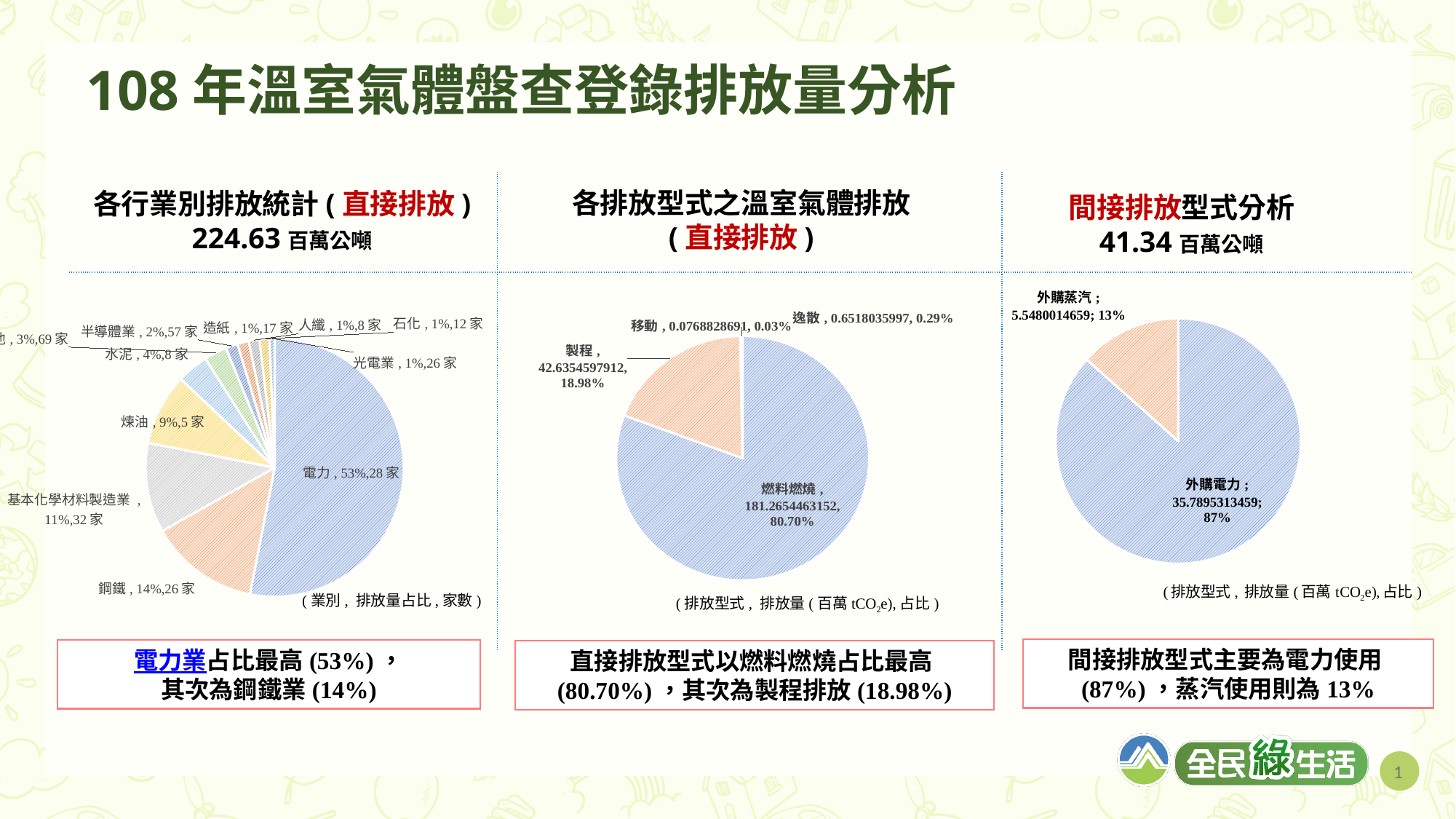
What type of chart is used for the 間接排放型式分析 on the right? Pie chart In the left chart (各行業別排放統計), how many 家 (companies) are listed for 鋼鐵? 26 家 In the middle chart (各排放型式之溫室氣體排放), which emission type has the smallest share? 移動 In the left chart (各行業別排放統計), what is the difference in percentage points between the 電力 share and the 鋼鐵 share? 39 In the middle chart (各排放型式之溫室氣體排放), how many emission types are shown? 4 In the left chart (各行業別排放統計), which is larger, the share of 煉油 or the share of 水泥? 煉油 In the middle chart (各排放型式之溫室氣體排放), what is the emission value for 燃料燃燒? 181.2654463152 In the right chart (間接排放型式分析), what share does 外購電力 have? 87% In the left chart (各行業別排放統計), what share of direct emissions comes from 電力? 53% In the middle chart (各排放型式之溫室氣體排放), what percentage share does 製程 have? 18.98% In the right chart (間接排放型式分析), what is the emission value for 外購蒸汽? 5.5480014659 In the left chart (各行業別排放統計), which industry has the largest share? 電力